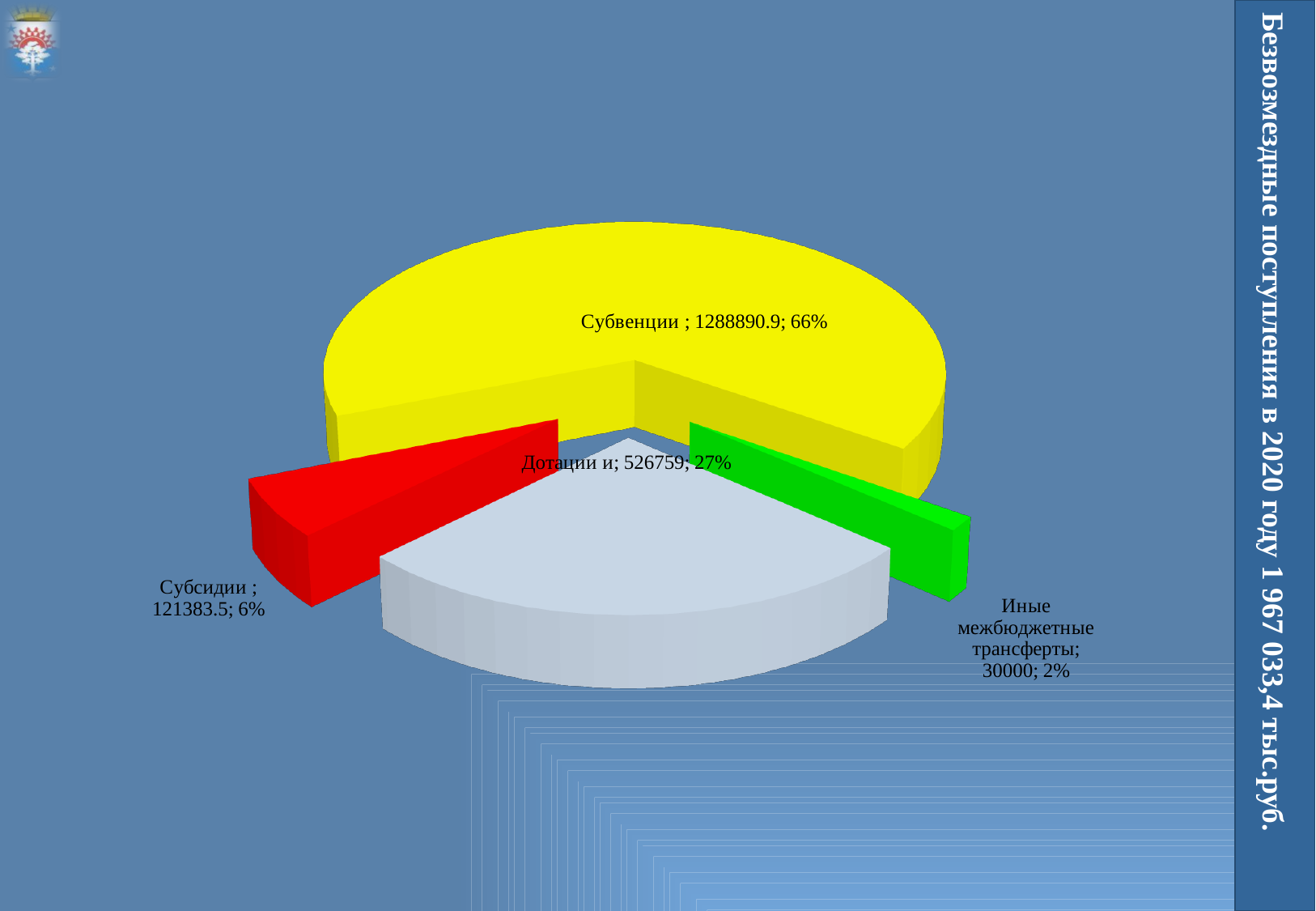
What percentage share does the Дотации и slice have? 27% What percentage share does the Субвенции slice have? 66% What is the value shown for Субвенции? 1288890.9 What kind of chart is shown on the slide? Pie chart How many slices does the pie chart have? 4 What colour is the Субвенции slice? Yellow Which category has the smallest share of the pie? Иные межбюджетные трансферты Which category has the largest share of the pie? Субвенции What is the value shown for Субсидии? 121383.5 Which is larger, the value for Дотации и or the value for Субсидии? Дотации и What is the difference between the value for Субсидии and the value for Иные межбюджетные трансферты? 91383.5 What is the value shown for Иные межбюджетные трансферты? 30000